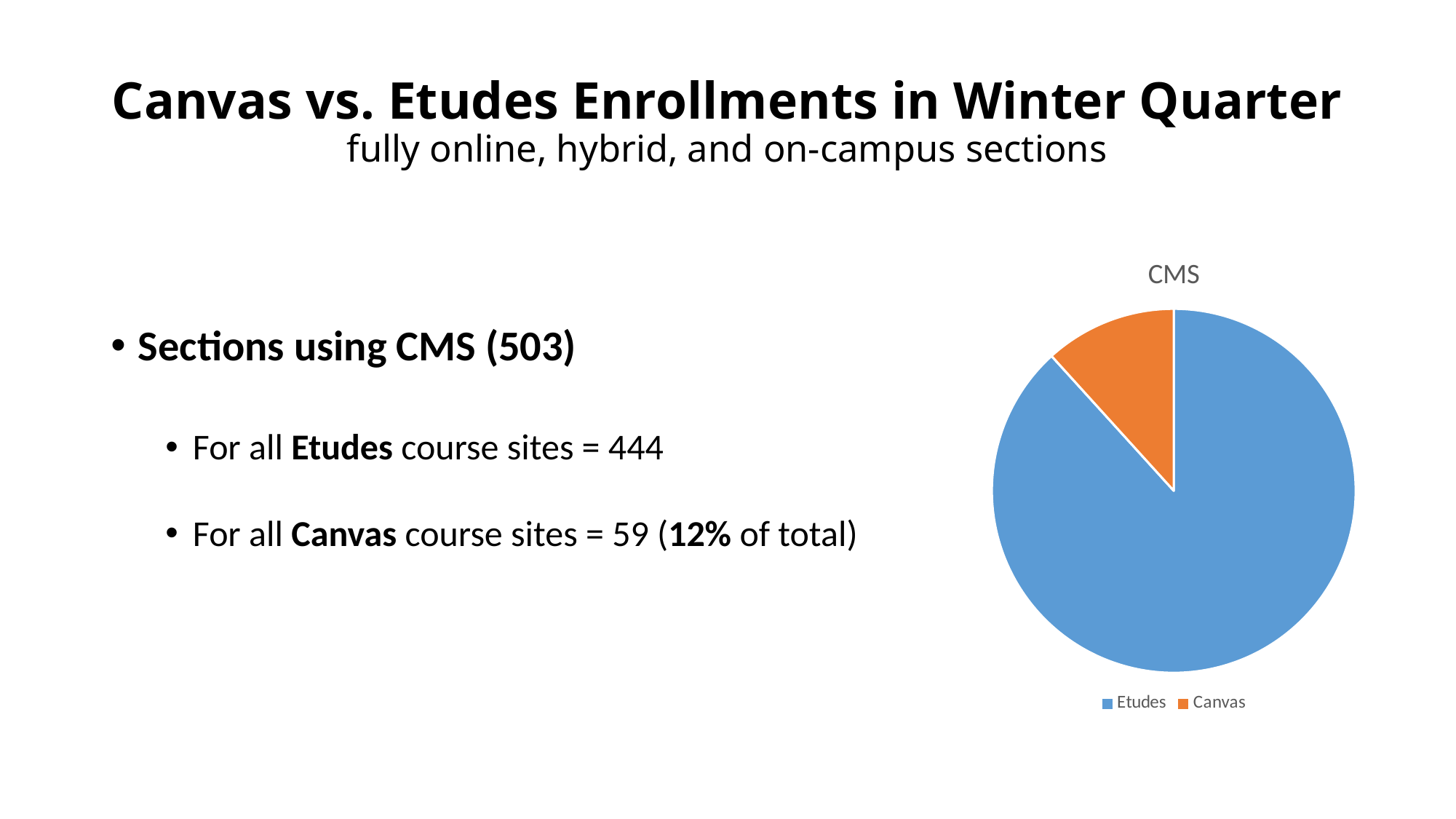
What kind of chart is shown on the slide? pie chart Which slice of the pie chart is the smallest? Canvas According to the slide, how many sections use Canvas course sites? 59 According to the slide, how many sections use Etudes course sites? 444 Which slice of the pie chart is the largest? Etudes What is the title of the pie chart? CMS What colour is the Canvas slice in the pie chart? orange What share of the total does the Canvas slice represent? 12% What is the total number of sections using a CMS represented by the pie chart? 503 How many entries does the pie chart's legend list? 2 How many slices does the pie chart have? 2 Which is larger in the pie chart, Etudes or Canvas? Etudes